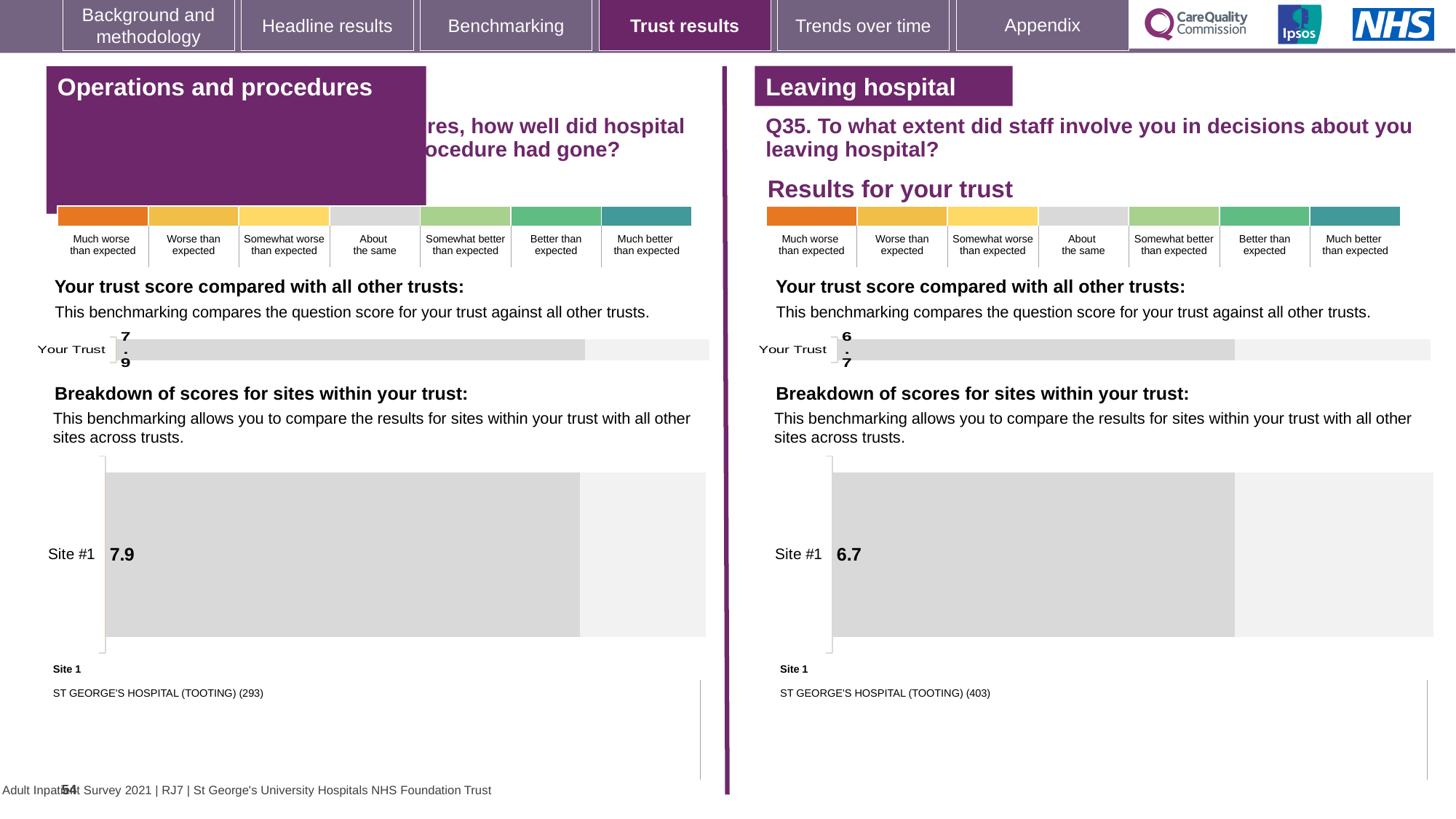
What is the question number and text shown above the right-hand 'Leaving hospital' charts? Q35. To what extent did staff involve you in decisions about you leaving hospital? What is the difference between the Site #1 score on the left-hand chart (7.9) and the Site #1 score on the right-hand chart (6.7)? 1.2 Which is larger: the 'Your Trust' score on the left-hand 'Operations and procedures' section or the 'Your Trust' score on the right-hand 'Leaving hospital' section? Operations and procedures (7.9) In the 'Breakdown of scores for sites within your trust' chart on the left-hand side, what is the value for Site #1? 7.9 What kind of chart is used to show the 'Your Trust' score on each side of the slide? Bar chart On the left-hand 'Operations and procedures' section, what is the score shown for 'Your Trust'? 7.9 Which site is listed as Site 1 under the right-hand 'Leaving hospital' breakdown chart? ST GEORGE'S HOSPITAL (TOOTING) (403) How many sites are shown in the 'Breakdown of scores for sites within your trust' chart on the right-hand side? 1 On the right-hand 'Leaving hospital' section, what is the score shown for 'Your Trust'? 6.7 In the 'Breakdown of scores for sites within your trust' chart on the right-hand side, what is the value for Site #1? 6.7 How many sites are shown in the 'Breakdown of scores for sites within your trust' chart on the left-hand side? 1